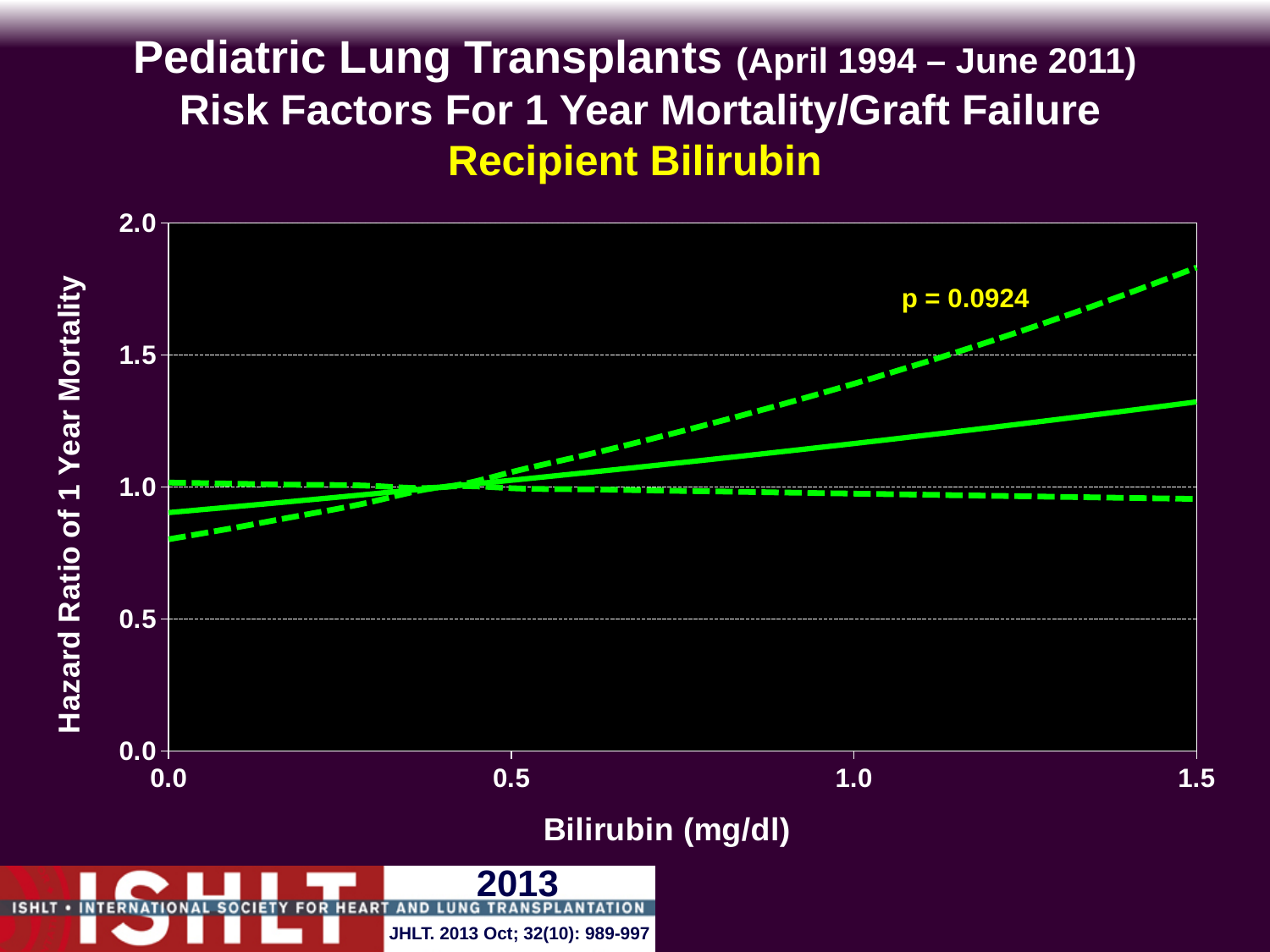
Is the value of the lower dashed line at a bilirubin of 0.0 mg/dl greater or less than 1.0? less What is the label of the y axis? Hazard Ratio of 1 Year Mortality What p-value is printed on the chart? p = 0.0924 How many lines are plotted on the chart? 3 What kind of chart is shown on the slide? line chart Is the value of the solid line at a bilirubin of 1.5 mg/dl greater or less than 1.5? less Is the value of the upper dashed line at a bilirubin of 1.5 mg/dl greater or less than 1.5? greater Does the upper dashed line rise or fall as bilirubin increases along the x axis? rises Does the solid line rise or fall as bilirubin increases from 0.0 to 1.5 mg/dl? rises What is the label of the x axis? Bilirubin (mg/dl)